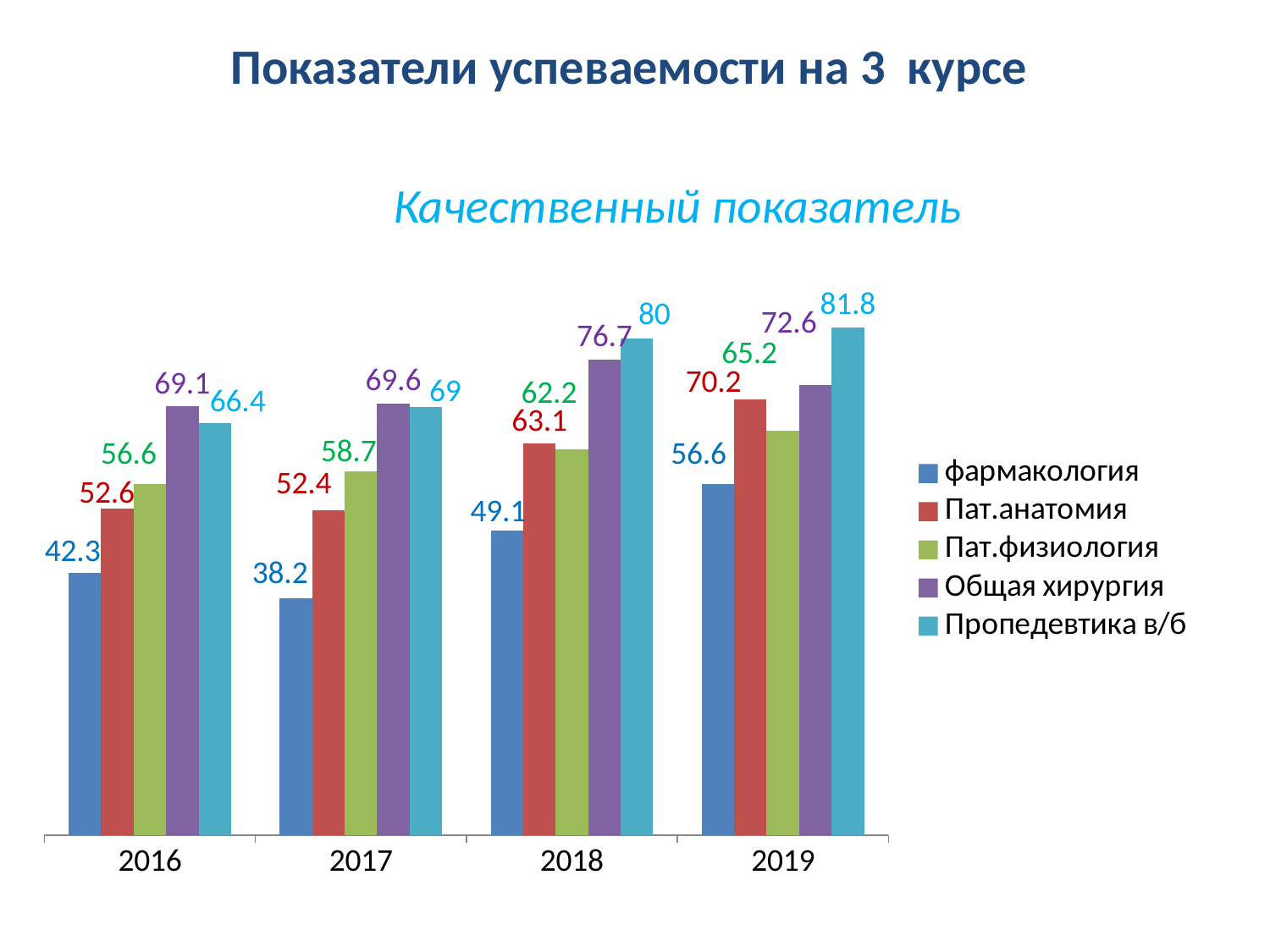
How many series does the legend list? 5 Does the value for Общая хирургия rise or fall from 2016 to 2018? rise What is the difference between the Пропедевтика в/б values in 2019 and 2016? 15.4 Which year has the lowest value for фармакология? 2017 Which is larger in 2018: Пат.анатомия or Пат.физиология? Пат.анатомия What is the value for фармакология in 2016? 42.3 How many years are shown on the x axis? 4 What is the value for Пропедевтика в/б in 2019? 81.8 What is the value for Общая хирургия in 2018? 76.7 Which series has the highest value in 2019? Пропедевтика в/б What kind of chart is shown on the slide? bar chart What is the value for Пат.анатомия in 2017? 52.4